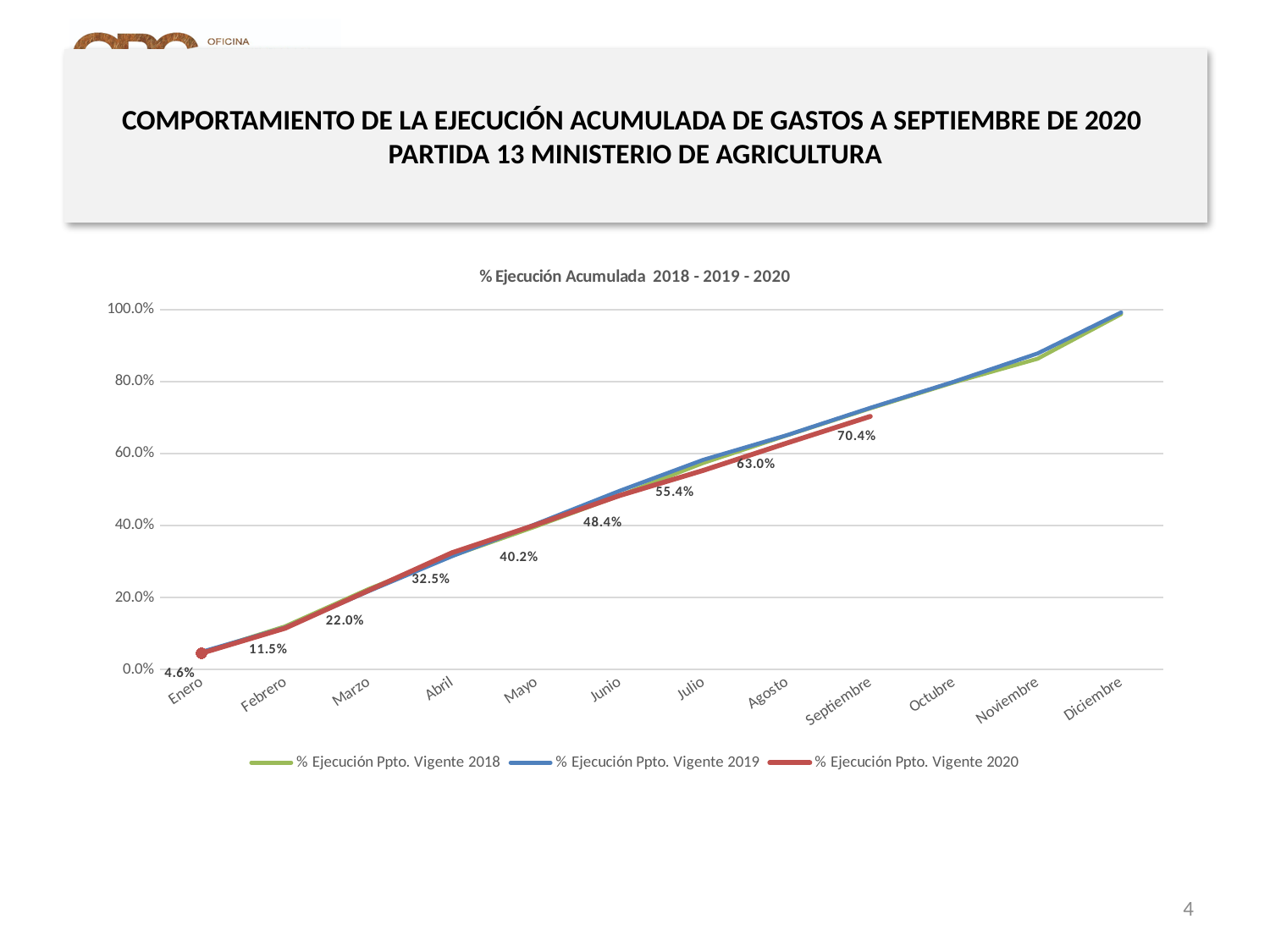
How many series does the legend list? 3 What is the value of % Ejecución Ppto. Vigente 2020 for Enero? 4.6% Does the % Ejecución Ppto. Vigente 2020 series rise or fall from Enero to Septiembre? rise What is the value of % Ejecución Ppto. Vigente 2020 for Mayo? 40.2% What is the difference between the 2020 values for Septiembre and Agosto? 7.4% Is the value for % Ejecución Ppto. Vigente 2019 in Diciembre greater or less than 80.0%? greater How many months are shown on the x axis? 12 What type of chart is shown on the slide? line chart What is the difference between the 2020 values for Marzo and Febrero? 10.5% What is the value of % Ejecución Ppto. Vigente 2020 for Septiembre? 70.4% What is the title of the chart? % Ejecución Acumulada 2018 - 2019 - 2020 What is the value of % Ejecución Ppto. Vigente 2020 for Julio? 55.4%